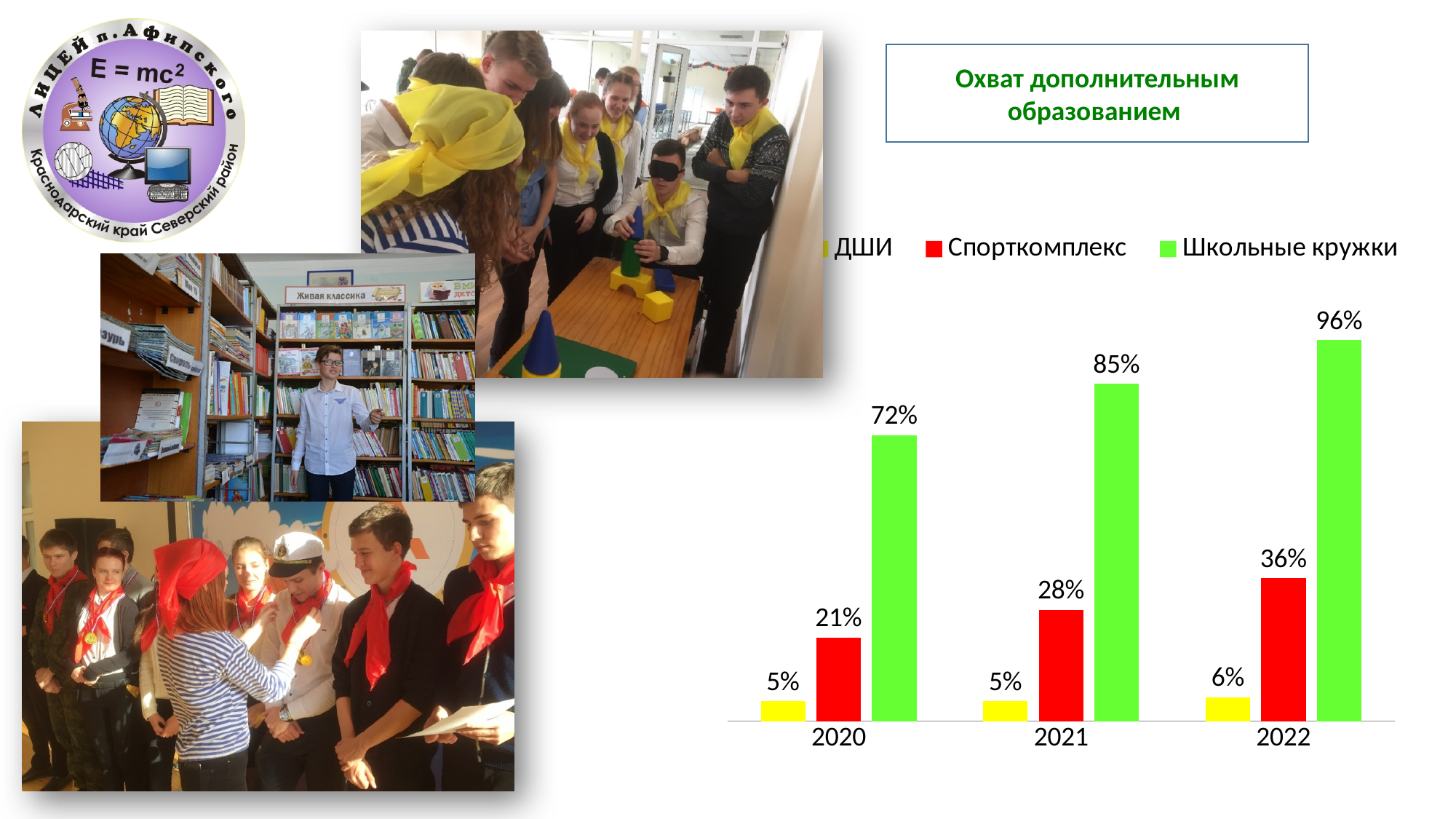
What is the value for Спорткомплекс in 2021? 28% How many years are shown on the x axis of the chart? 3 In which year is the value for Школьные кружки the highest? 2022 What is the value for ДШИ in 2020? 5% In which year is the value for Спорткомплекс the lowest? 2020 What is the difference between the Школьные кружки values for 2022 and 2020? 24% What type of chart is shown on the slide? Bar chart What is the value for Школьные кружки in 2022? 96% Which is larger: the Спорткомплекс value in 2022 or the Школьные кружки value in 2020? Школьные кружки in 2020 Do the values for Спорткомплекс rise or fall from 2020 to 2022? Rise How many series does the chart legend list? 3 What is the value for Спорткомплекс in 2020? 21%